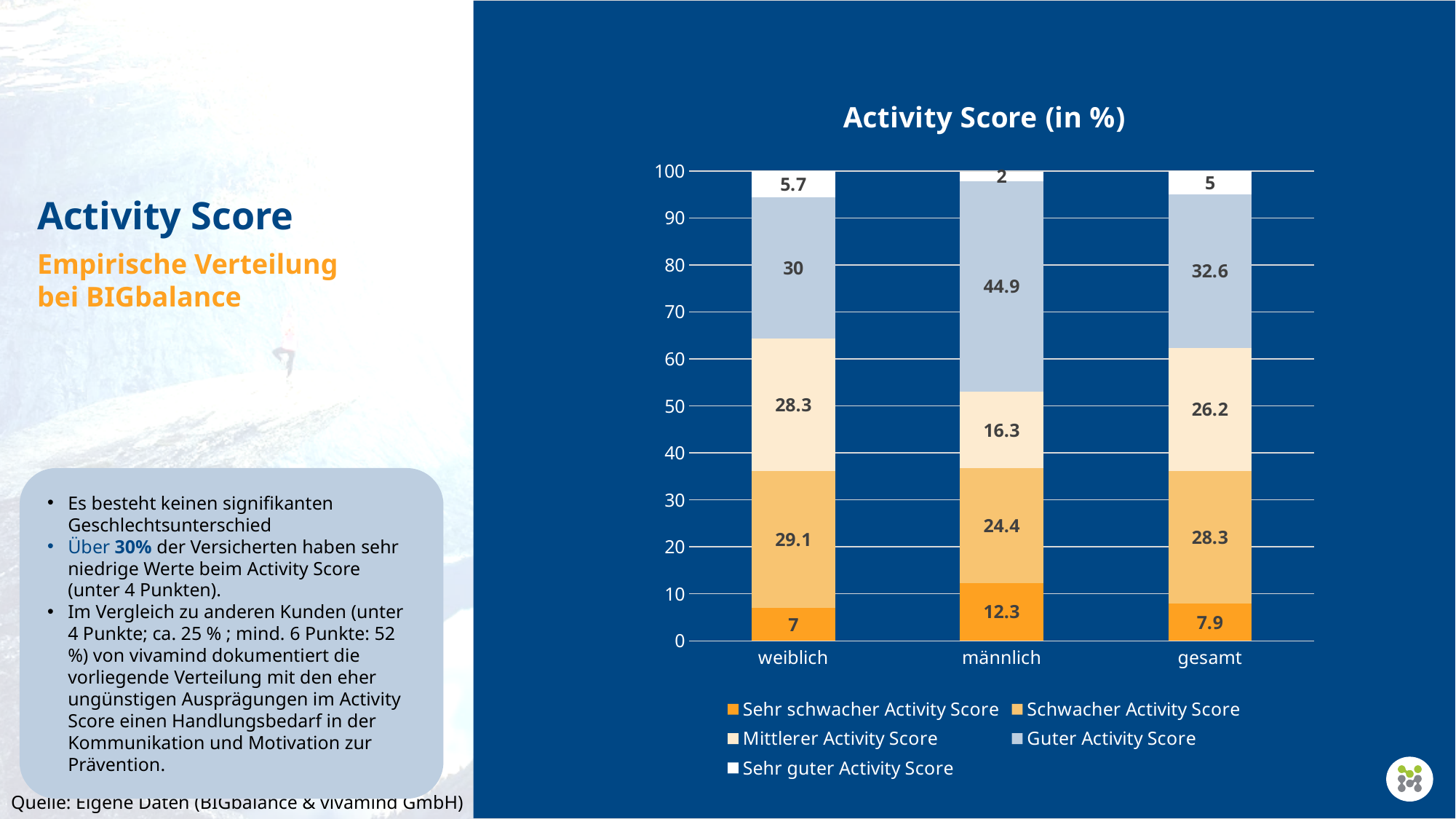
What is the value of Guter Activity Score for weiblich? 30 Which category has the lowest value for Sehr guter Activity Score? männlich How many categories are shown on the x axis? 3 What type of chart is shown on the slide? Stacked bar chart Which is larger: the Mittlerer Activity Score for weiblich or for männlich? weiblich Which category has the highest value for Guter Activity Score? männlich How many series does the legend list? 5 What is the title of the chart? Activity Score (in %) What is the difference between the Schwacher Activity Score values for weiblich and männlich? 4.7 What is the total of the stacked bar for gesamt? 100 What is the value of Mittlerer Activity Score for gesamt? 26.2 What is the value of Sehr schwacher Activity Score for männlich? 12.3